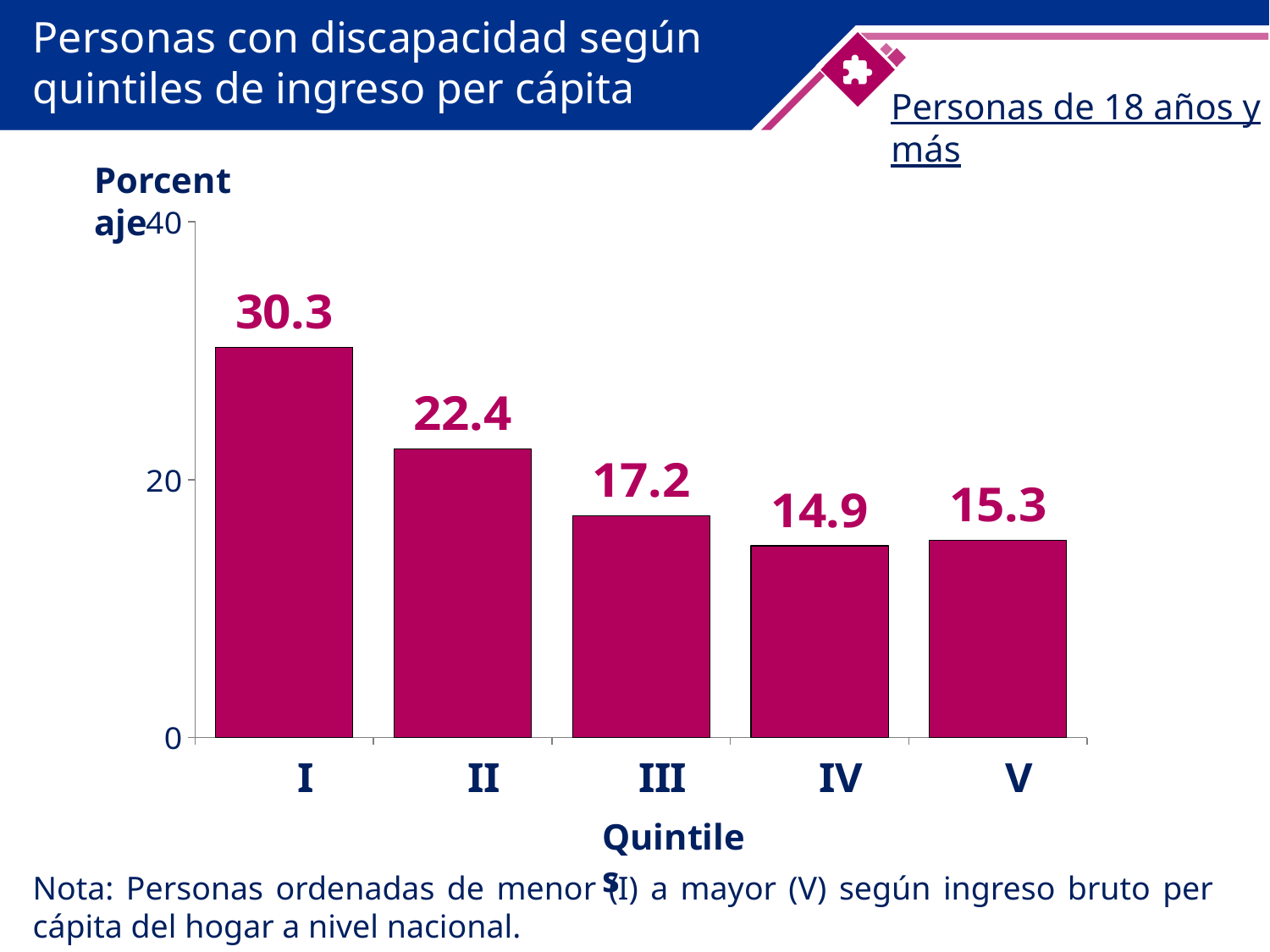
Which quintile has the lowest value? IV Which is larger, the value for quintile II or the value for quintile III? quintile II Which quintile has the highest value? I What is the label of the x axis? Quintiles What is the value for quintile III? 17.2 What is the value for quintile I? 30.3 What is the value for quintile V? 15.3 How many quintiles are shown on the x axis? 5 What is the difference between the values for quintile III and quintile IV? 2.3 What kind of chart is shown on the slide? bar chart What is the difference between the values for quintile I and quintile II? 7.9 Is the value for quintile I greater or less than 20? greater